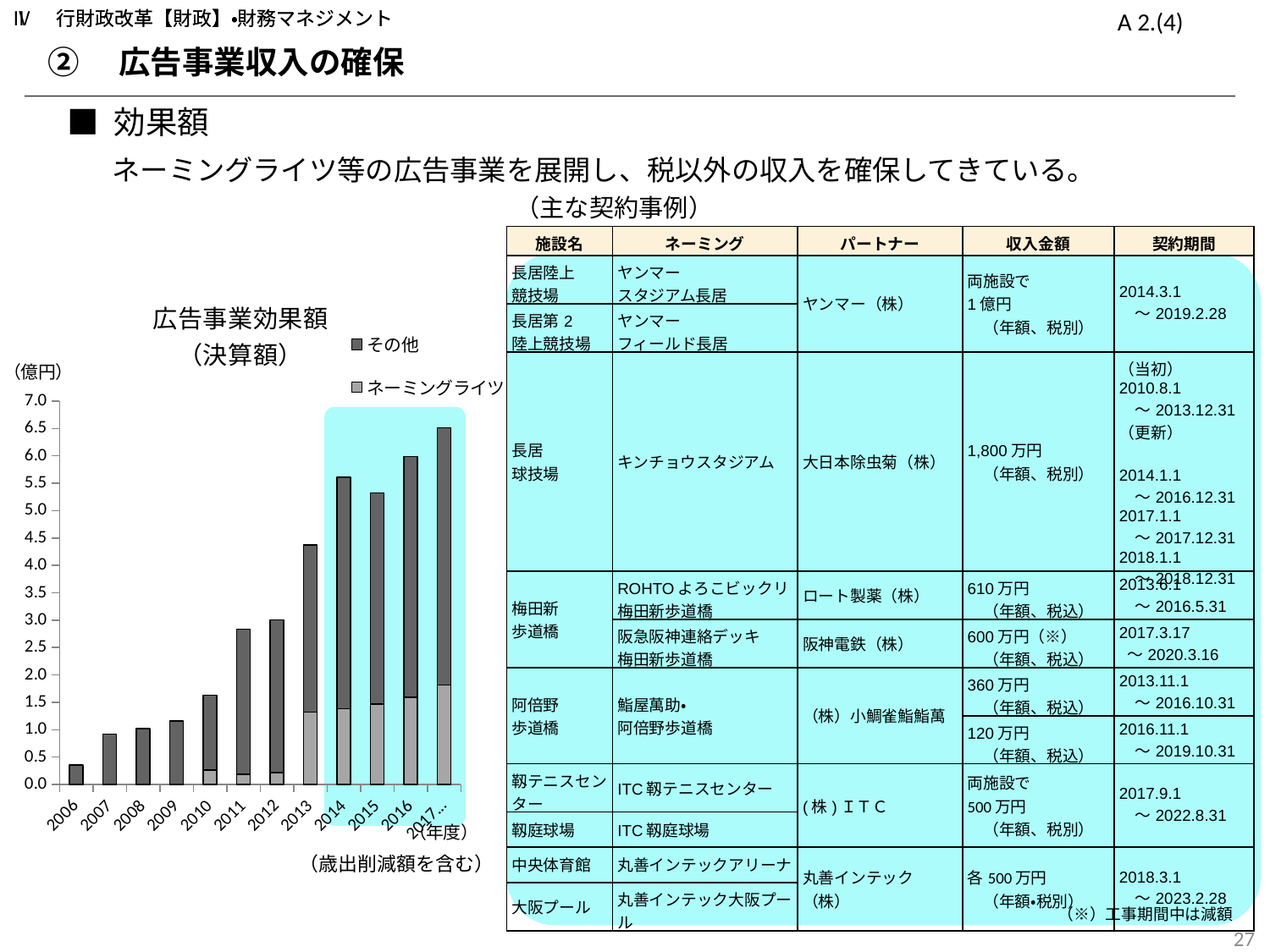
In the 広告事業効果額（決算額） chart, is the total value for 2013 greater or less than 4.0? greater What kind of chart is the 広告事業効果額（決算額） chart? bar chart What unit is shown on the y axis of the 広告事業効果額（決算額） chart? 億円 What are the two legend entries in the 広告事業効果額（決算額） chart? その他, ネーミングライツ In the 広告事業効果額（決算額） chart, which fiscal year has the larger total bar, 2014 or 2015? 2014 How many series does the legend of the 広告事業効果額（決算額） chart list? 2 Do the total bar values in the 広告事業効果額（決算額） chart generally rise or fall from 2006 to 2017? rise How many fiscal years are shown on the x axis of the 広告事業効果額（決算額） chart? 12 Which fiscal year has the highest total bar in the 広告事業効果額（決算額） chart? 2017 In the 広告事業効果額（決算額） chart, is the total value for 2006 greater or less than 0.5? less In the 広告事業効果額（決算額） chart, is the total value for 2017 greater or less than 6.0? greater Which fiscal year has the lowest total bar in the 広告事業効果額（決算額） chart? 2006